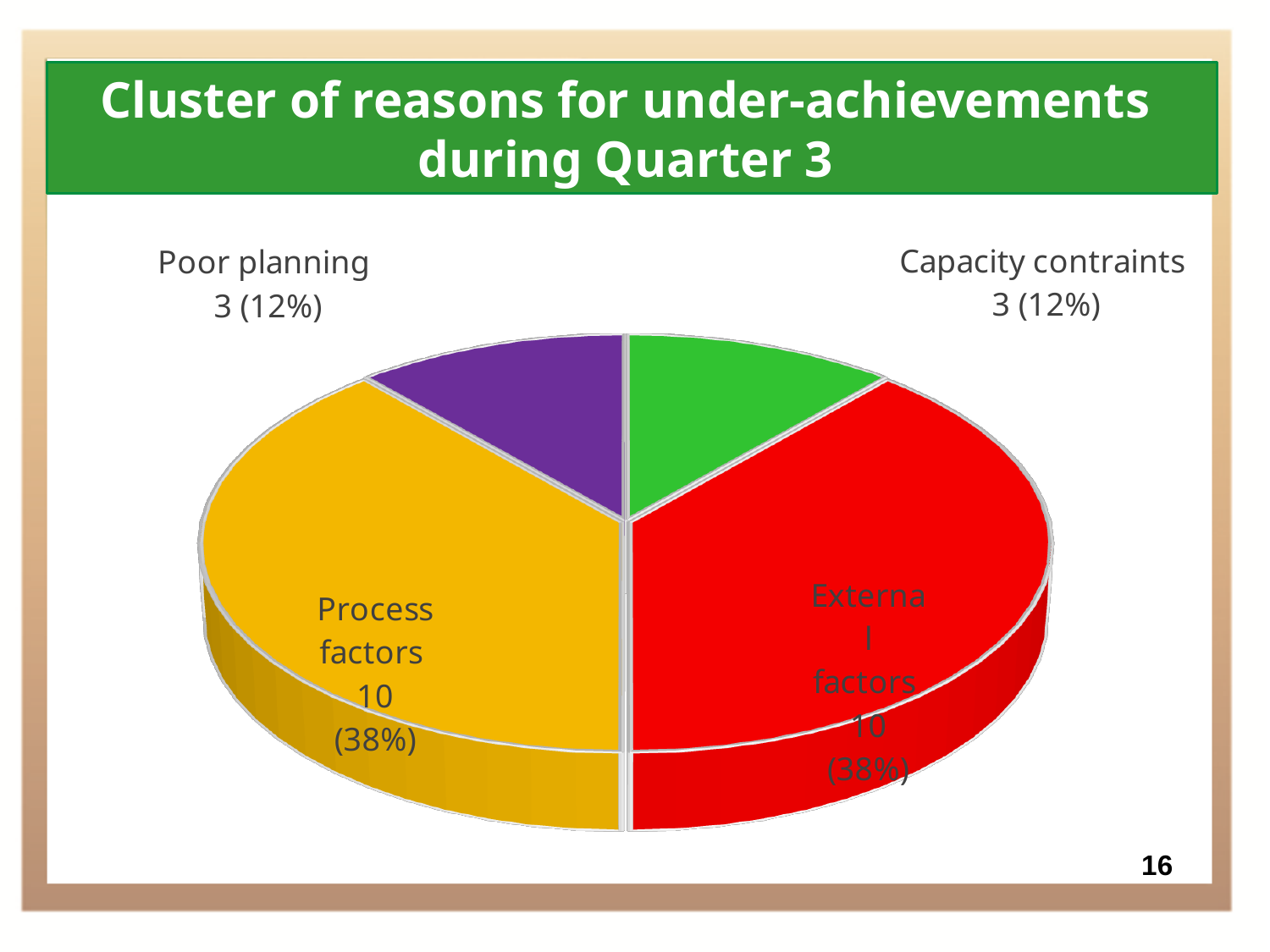
What colour is the slice for External factors? Red Which is larger, the value for Process factors or the value for Poor planning? Process factors What kind of chart is shown on the slide? Pie chart What is the value for Poor planning? 3 What is the value for Capacity contraints? 3 What share of the pie does Poor planning represent? 12% What is the value for External factors? 10 What is the title of the chart? Cluster of reasons for under-achievements during Quarter 3 What is the difference between the values for External factors and Capacity contraints? 7 How many slices does the pie chart have? 4 What is the value for Process factors? 10 What share of the pie does Process factors represent? 38%